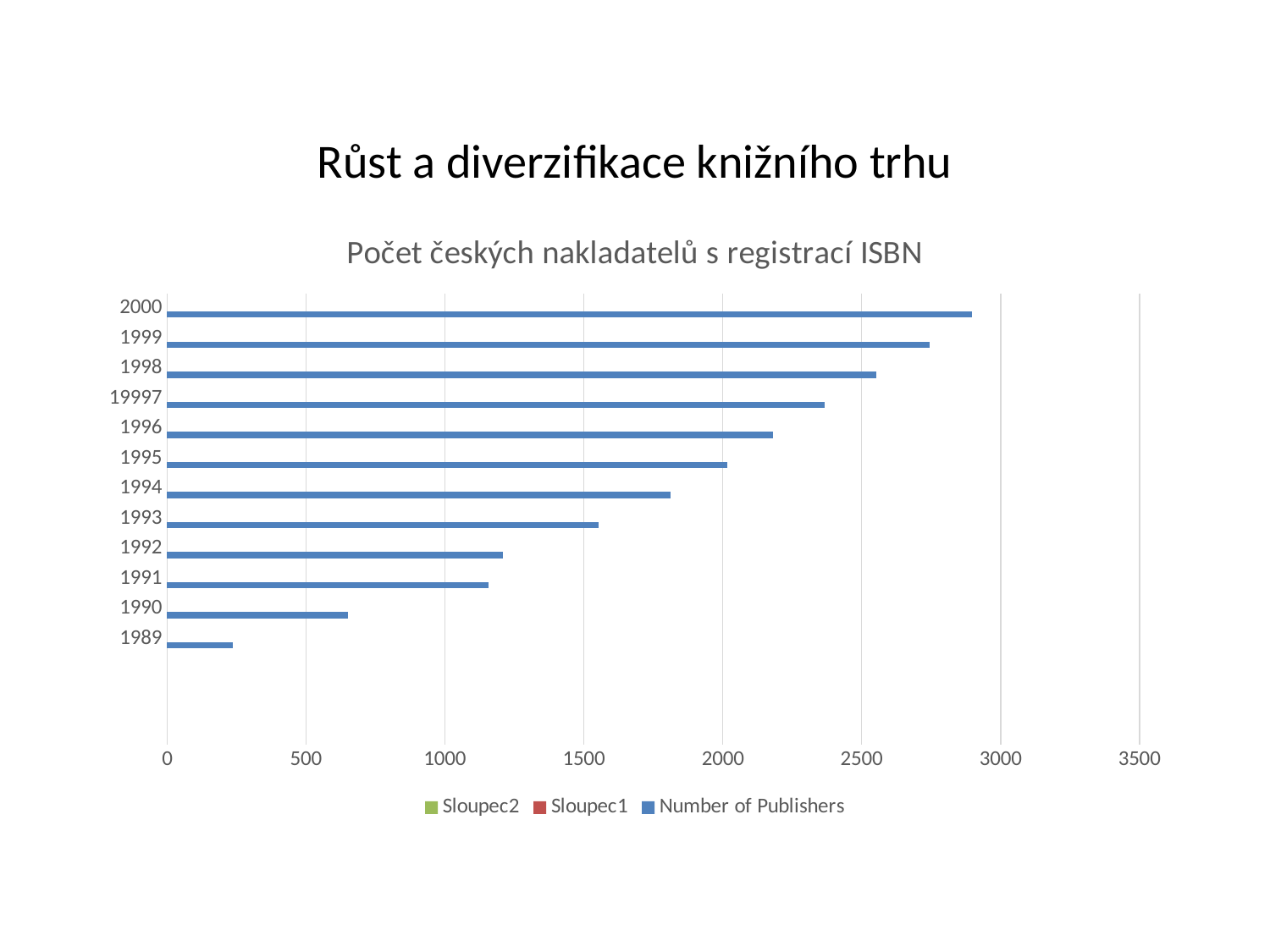
How many series does the legend list? 3 Is the value for 2000 greater or less than 2500? greater What kind of chart is shown on the slide? bar chart Which year has more publishers, 1998 or 1994? 1998 Is the value for 1994 greater or less than 2000? less What is the title of the chart? Počet českých nakladatelů s registrací ISBN Which year has the highest number of publishers? 2000 Which year has the lowest number of publishers? 1989 How many year categories are shown on the chart? 12 Is the value for 1989 greater or less than 500? less Do the number of publishers rise or fall from 1989 to 2000? rise